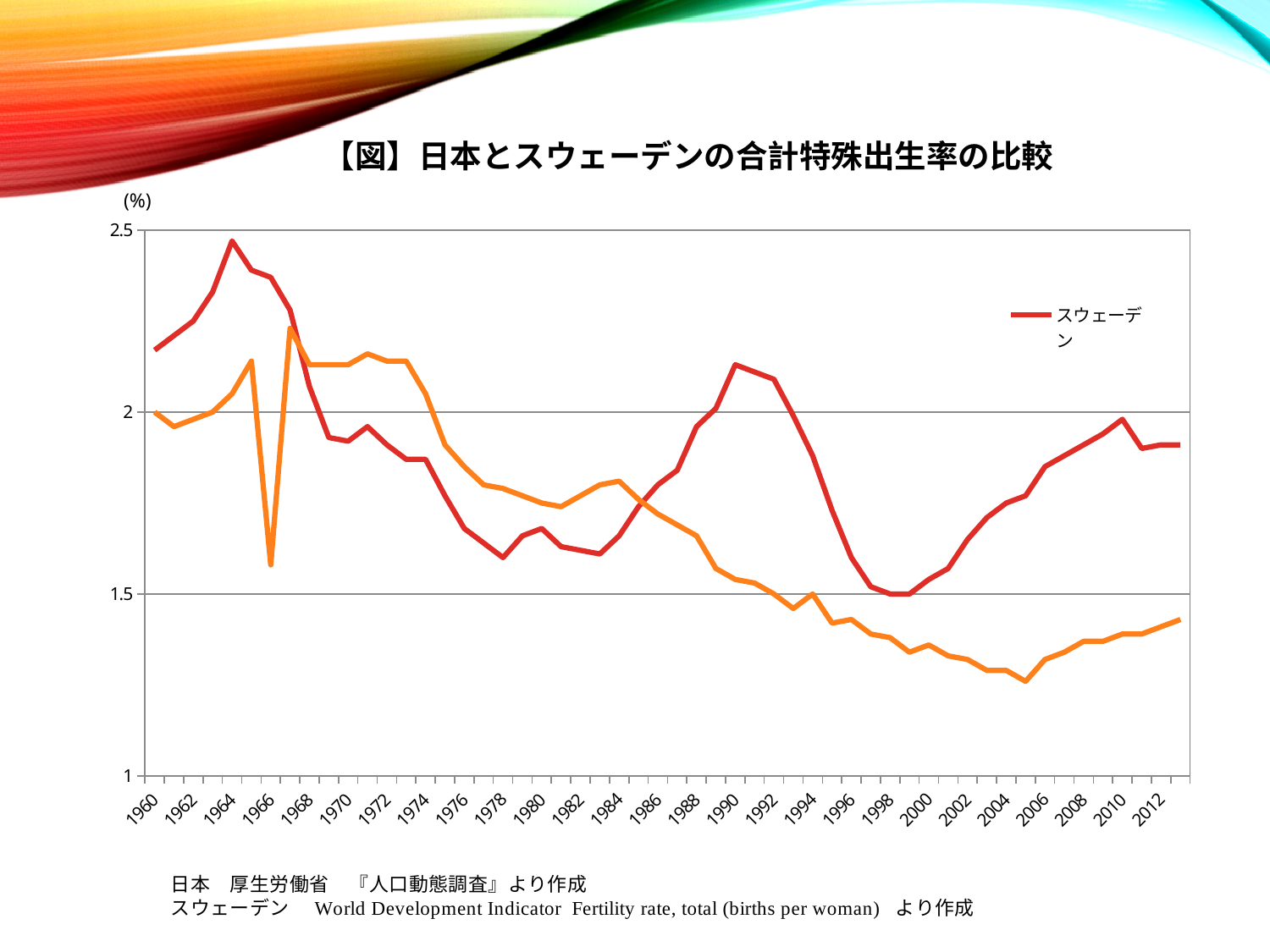
What is the title of the chart? 【図】日本とスウェーデンの合計特殊出生率の比較 How many series does the chart's legend list? 1 Does the スウェーデン line rise or fall between 1990 and 1998? fall What kind of chart is shown on the slide? line chart Which series is named in the chart's legend? スウェーデン In 2012, which line is higher, the red スウェーデン line or the orange line? the red スウェーデン line Is the value of the orange line in 1967 greater or less than 2? greater Is the value of the スウェーデン line in 1990 greater or less than 2? greater In 1984, which line is higher, the red スウェーデン line or the orange line? the orange line Is the value of the orange line in 2005 greater or less than 1.5? less